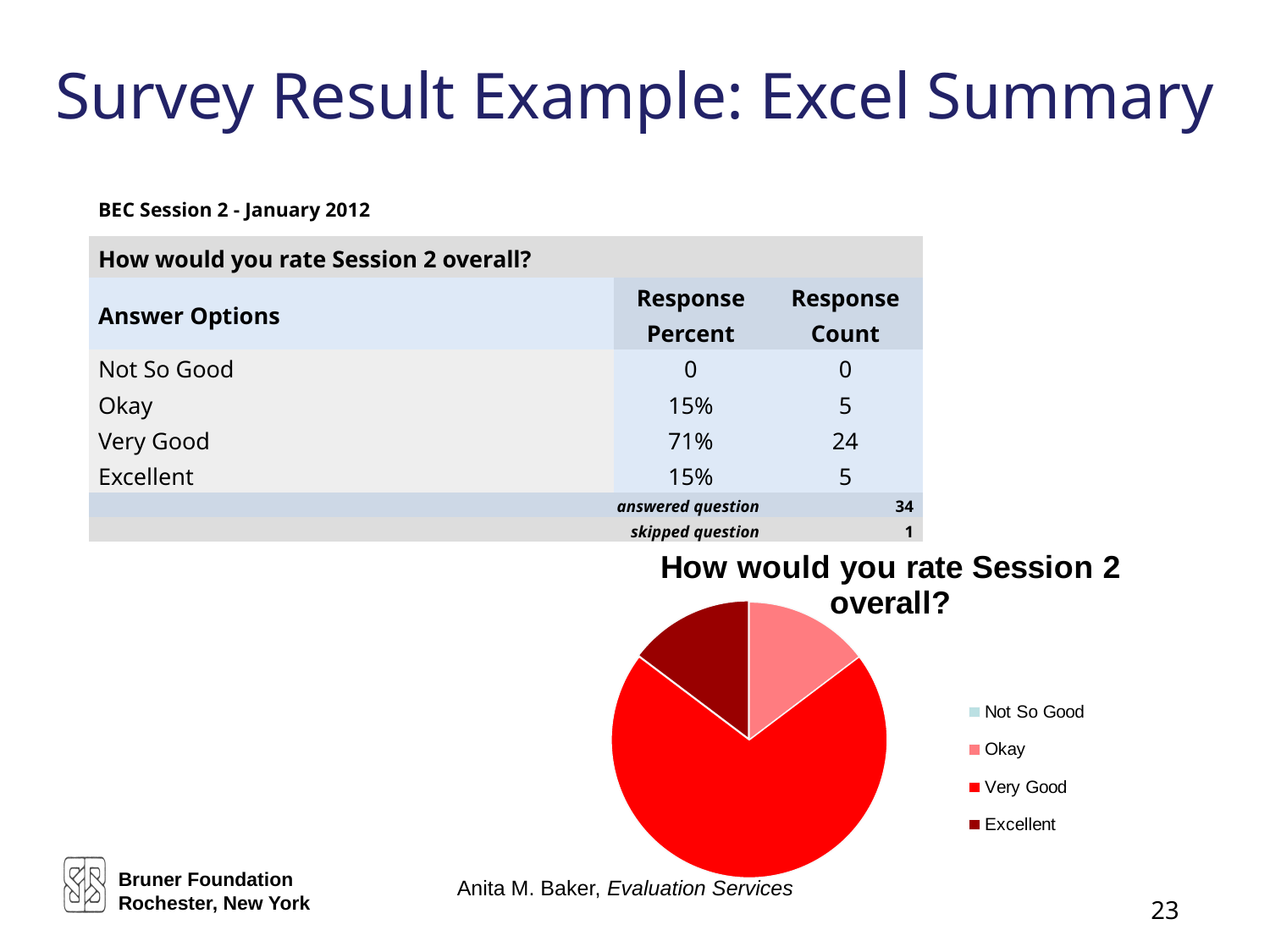
What is the response count for Excellent? 5 What share of the pie does Okay represent? 15% Which category has the largest slice of the pie chart? Very Good What is the title of the pie chart? How would you rate Session 2 overall? Which slice is larger, Very Good or Excellent? Very Good What is the response count for Very Good? 24 What colour is the Very Good slice in the pie chart? red Which category has the smallest share of the pie chart? Not So Good What kind of chart is shown on the slide? pie chart What is the difference in response count between Very Good and Okay? 19 How many categories does the pie chart's legend list? 4 What share of the pie does Very Good represent? 71%